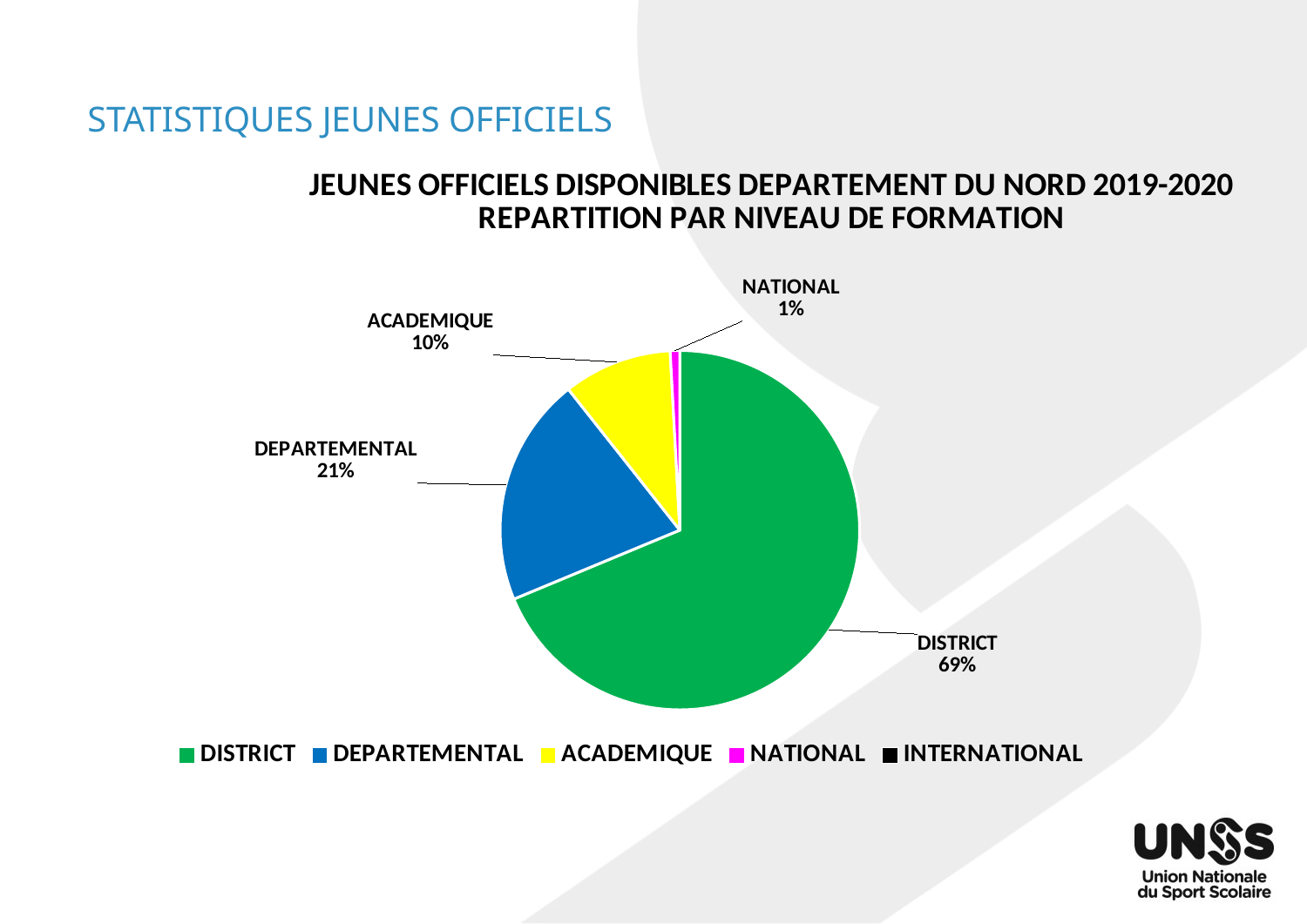
Which category has the largest slice of the pie? DISTRICT How many categories does the legend list? 5 Which labelled category has the smallest slice of the pie? NATIONAL What is the value shown for DEPARTEMENTAL? 21% What share of the pie does DISTRICT represent? 69% Which is larger, the share for ACADEMIQUE or the share for DEPARTEMENTAL? DEPARTEMENTAL What is the difference between the DEPARTEMENTAL and ACADEMIQUE shares? 11% What is the difference between the DISTRICT and DEPARTEMENTAL shares? 48% What is the chart title? JEUNES OFFICIELS DISPONIBLES DEPARTEMENT DU NORD 2019-2020 REPARTITION PAR NIVEAU DE FORMATION What is the value shown for ACADEMIQUE? 10% What is the value shown for NATIONAL? 1% What kind of chart is shown on the slide? pie chart